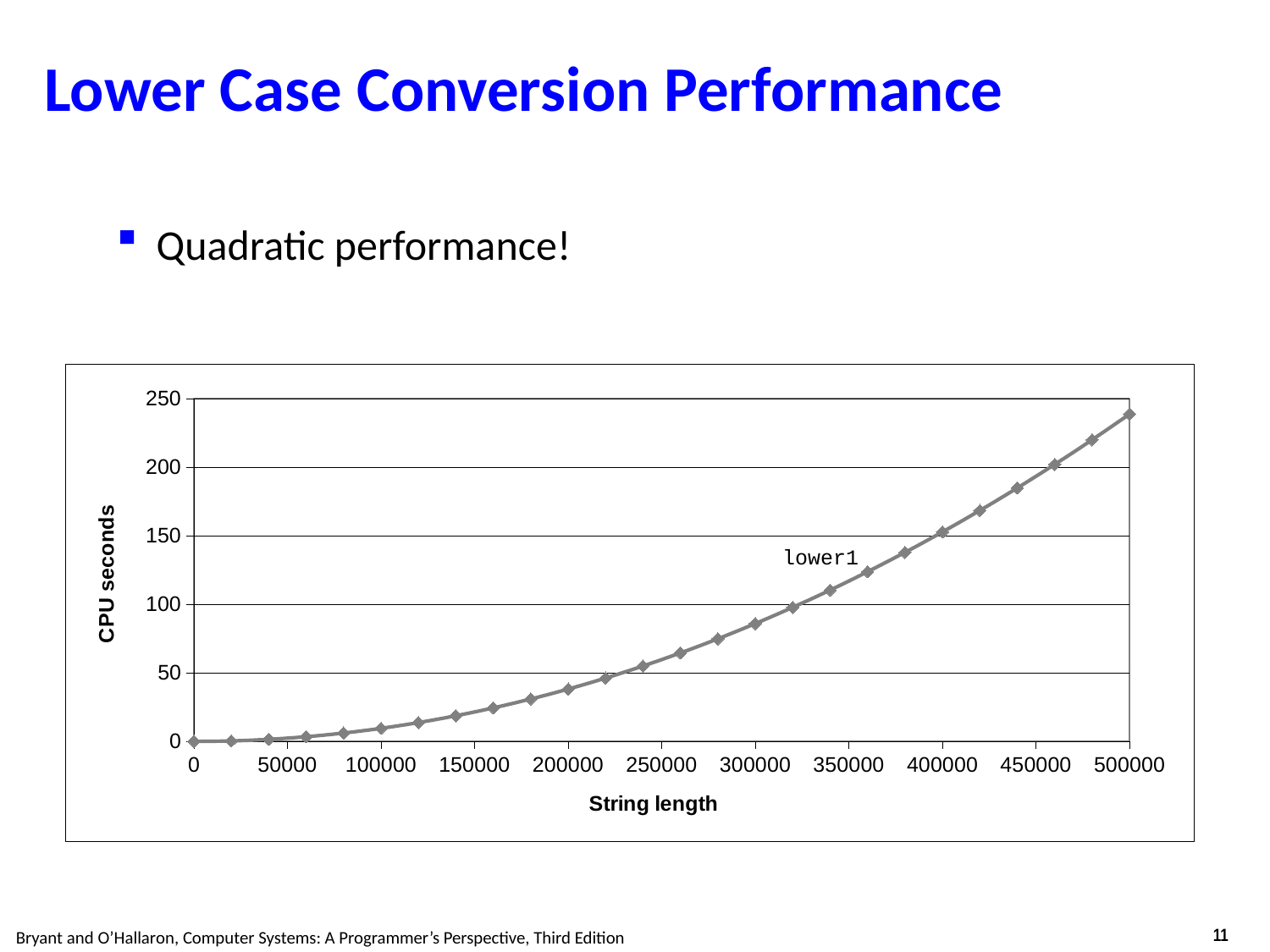
Is the CPU seconds value at string length 300000 greater or less than 100? less Is the CPU seconds value at string length 400000 greater or less than 100? greater Do the CPU seconds rise or fall as string length increases? rise Which has the larger CPU seconds value: string length 200000 or string length 400000? 400000 How many series does the chart plot? 1 What is the name of the series plotted on the chart? lower1 Is the CPU seconds value at string length 500000 greater or less than 200? greater At which string length is the CPU seconds value highest? 500000 What kind of chart is shown on the slide? line chart What is the label of the y axis? CPU seconds At which string length is the CPU seconds value lowest? 0